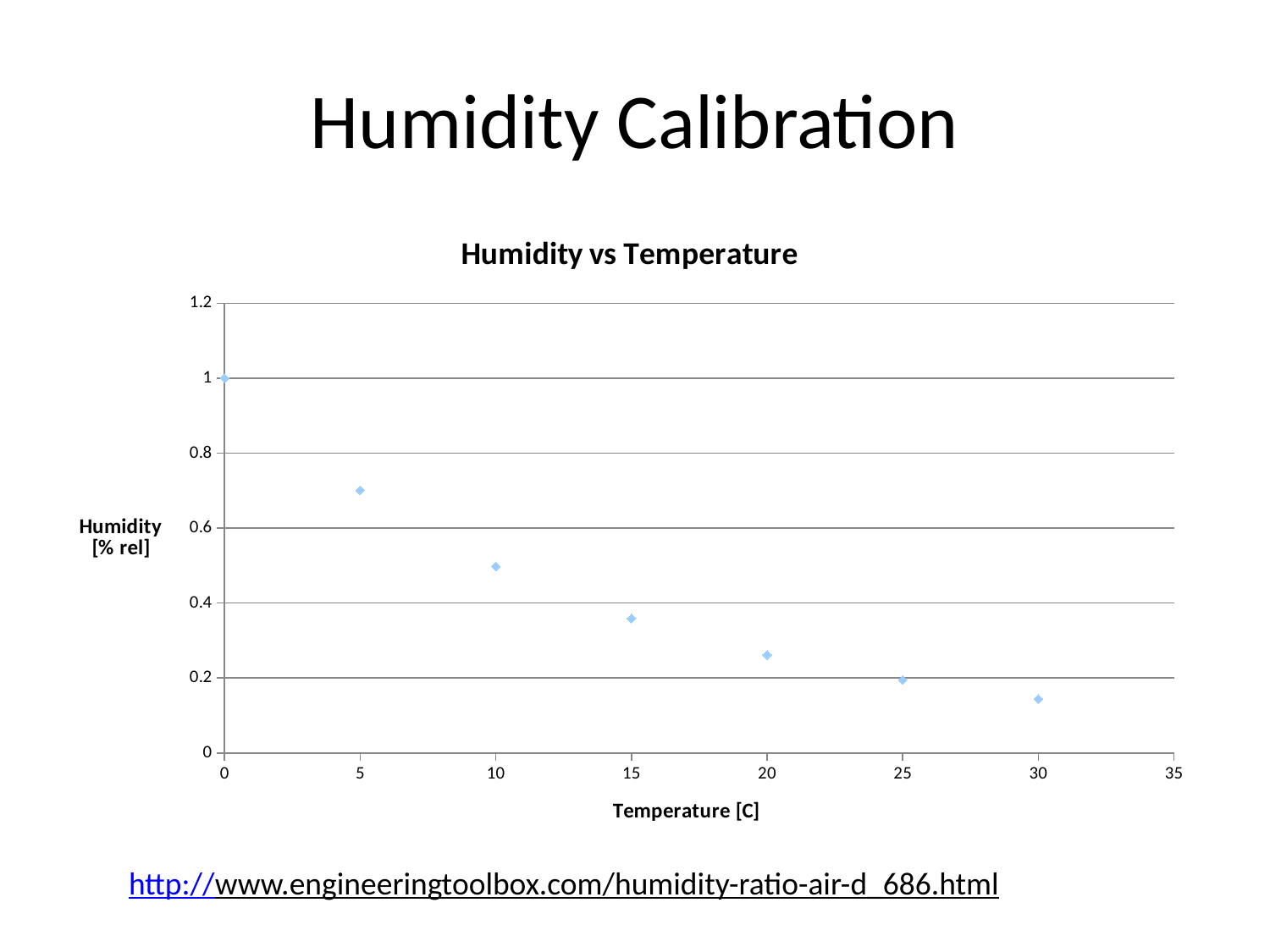
Is the humidity value at 30 C greater or less than 0.2? less Do the humidity values rise or fall as temperature increases? fall At which temperature is the humidity lowest? 30 At which temperature is the humidity highest? 0 What is the humidity value at a temperature of 0 C? 1 What type of chart is shown on the slide? scatter chart Which has the larger humidity value, 10 C or 20 C? 10 C What is the title of the chart? Humidity vs Temperature Is the humidity value at 15 C greater or less than 0.4? less How many data points are plotted in the chart? 7 What is the label of the x axis? Temperature [C] Is the humidity value at 5 C greater or less than 0.6? greater